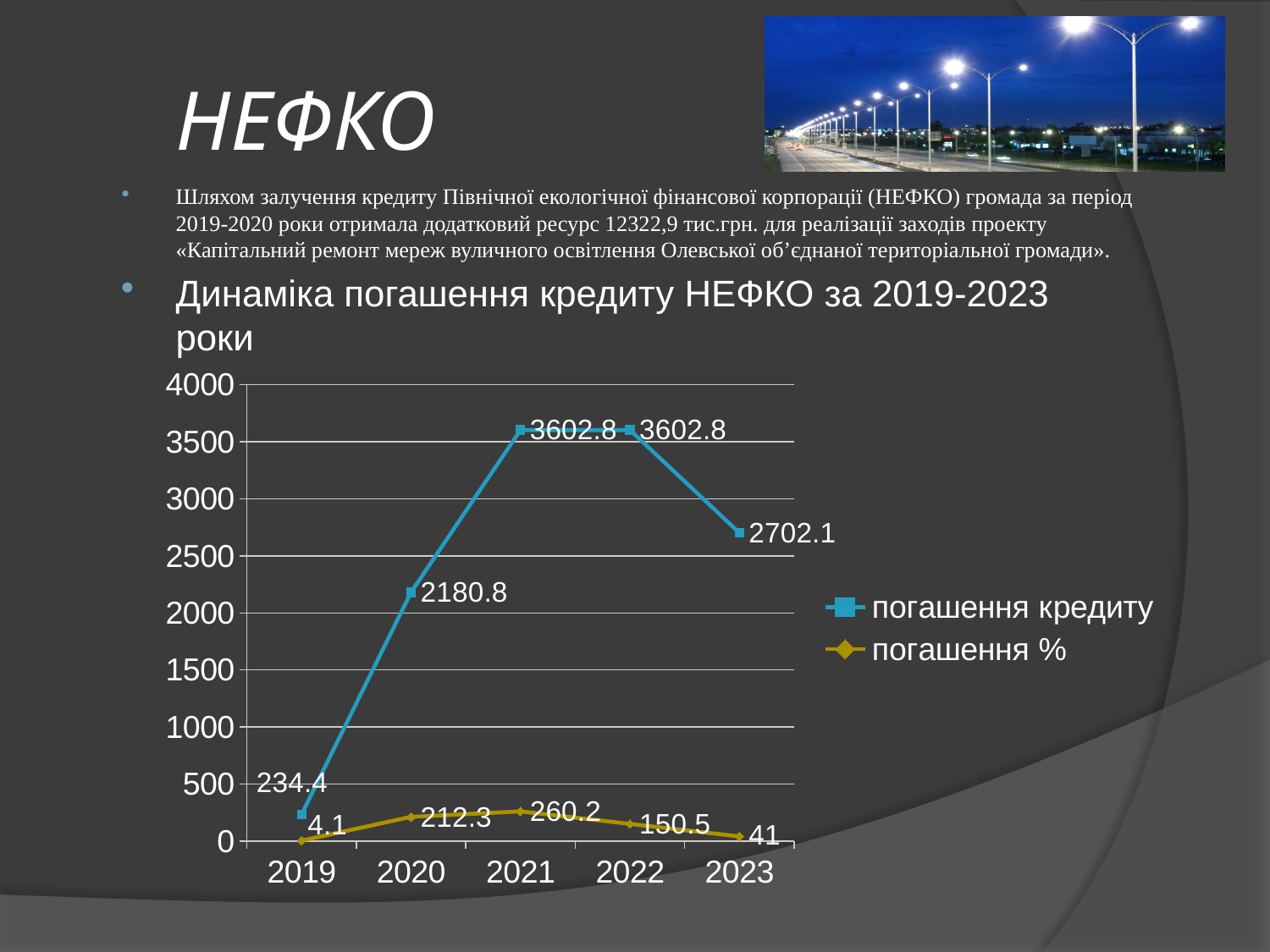
Which is larger for "погашення %": the value for 2022 or the value for 2023? 2022 What is the value of "погашення кредиту" for 2020? 2180.8 How many years are shown on the x axis of the chart? 5 How many series does the chart legend list? 2 What type of chart is shown on the slide? line chart In which year is "погашення кредиту" the lowest? 2019 What is the value of "погашення %" for 2021? 260.2 In which year is "погашення %" the highest? 2021 What is the value of "погашення кредиту" for 2023? 2702.1 What is the value of "погашення %" for 2019? 4.1 Does "погашення кредиту" rise or fall from 2022 to 2023? fall What is the difference between "погашення кредиту" in 2021 and in 2020? 1422